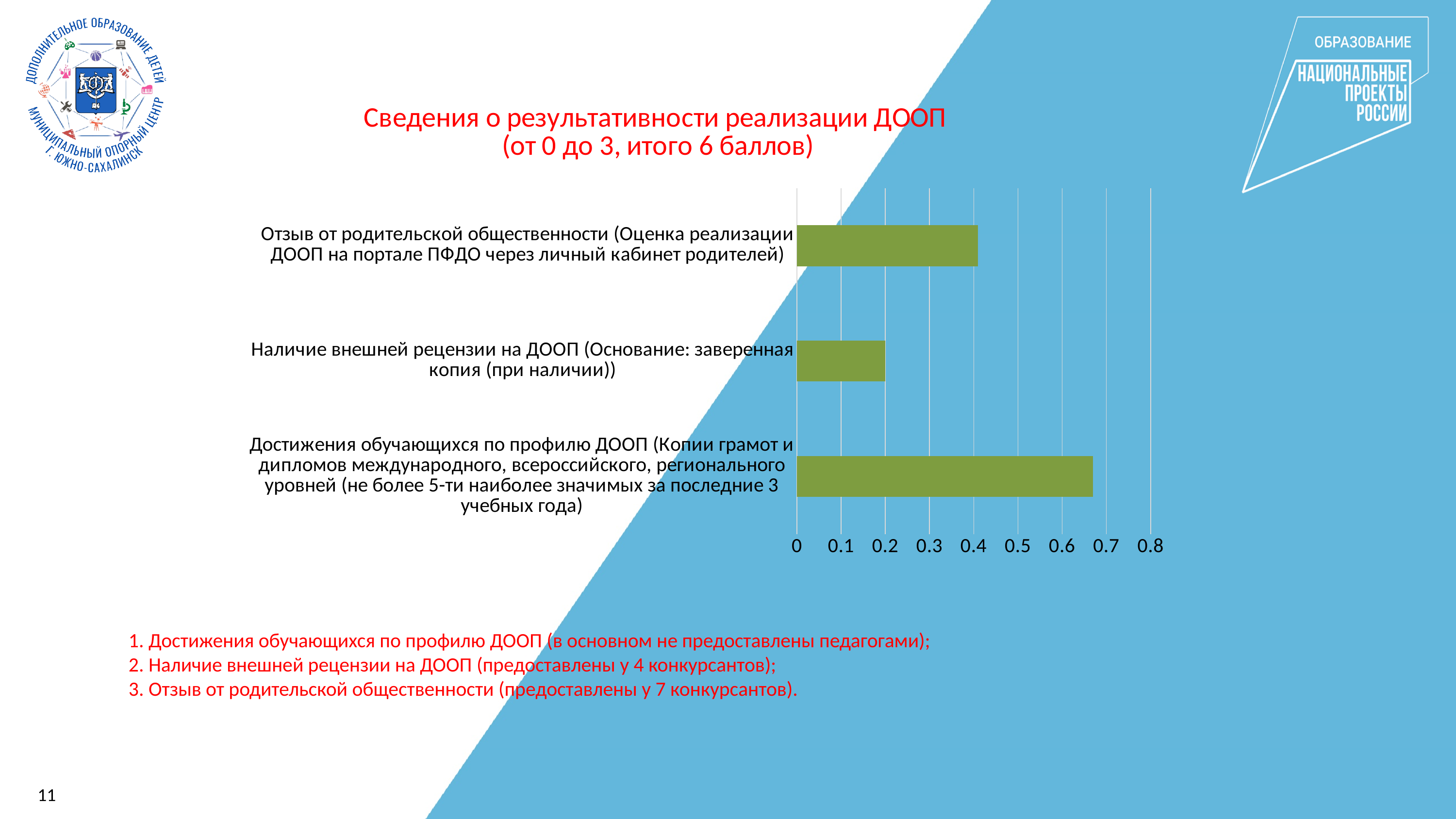
Is the value for 'Отзыв от родительской общественности' greater or less than 0.5? less Which is larger: the value for 'Достижения обучающихся по профилю ДООП' or the value for 'Отзыв от родительской общественности'? Достижения обучающихся по профилю ДООП Is the value for 'Отзыв от родительской общественности' greater or less than 0.3? greater How many categories does the chart show? 3 Which category has the highest value in the chart? Достижения обучающихся по профилю ДООП Is the value for 'Достижения обучающихся по профилю ДООП' greater or less than 0.6? greater What is the highest value shown on the chart's horizontal axis? 0.8 Which category has the lowest value in the chart? Наличие внешней рецензии на ДООП What kind of chart is shown on the slide? bar chart What colour are the bars in the chart? green Which is larger: the value for 'Отзыв от родительской общественности' or the value for 'Наличие внешней рецензии на ДООП'? Отзыв от родительской общественности